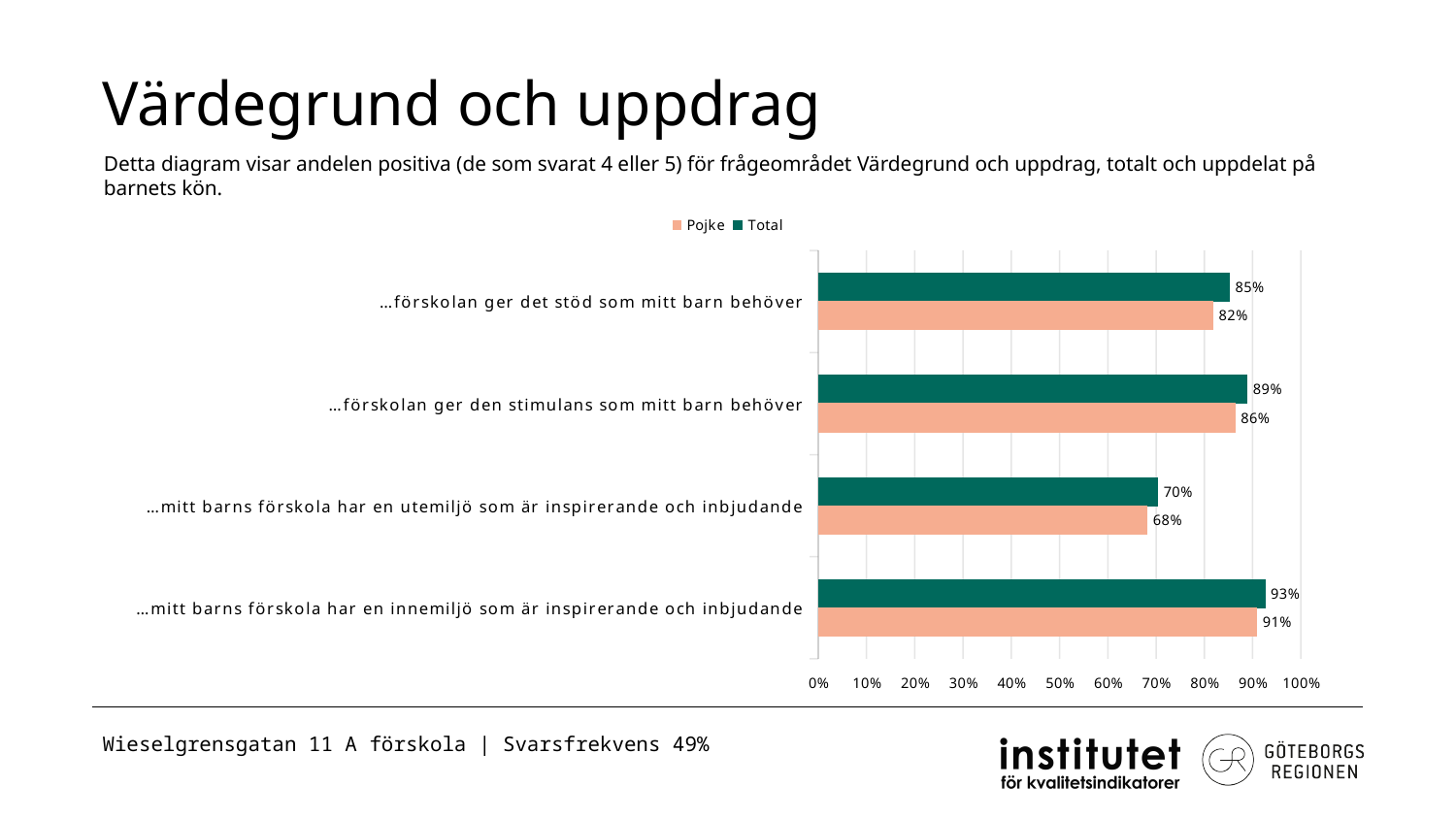
Which series is shown in green? Total What is the Pojke value for "…mitt barns förskola har en utemiljö som är inspirerande och inbjudande"? 68% What kind of chart is shown on the slide? Bar chart What is the difference between the Total and Pojke values for "…mitt barns förskola har en innemiljö som är inspirerande och inbjudande"? 2% What is the Pojke value for "…förskolan ger den stimulans som mitt barn behöver"? 86% Which category has the highest Total value? …mitt barns förskola har en innemiljö som är inspirerande och inbjudande What is the Total value for "…förskolan ger det stöd som mitt barn behöver"? 85% Which is larger: the Total value for "…förskolan ger den stimulans som mitt barn behöver" or the Total value for "…förskolan ger det stöd som mitt barn behöver"? …förskolan ger den stimulans som mitt barn behöver How many categories are shown on the chart? 4 Which category has the lowest Pojke value? …mitt barns förskola har en utemiljö som är inspirerande och inbjudande How many series does the legend list? 2 Is the Total value for "…mitt barns förskola har en utemiljö som är inspirerande och inbjudande" greater or less than 80%? less